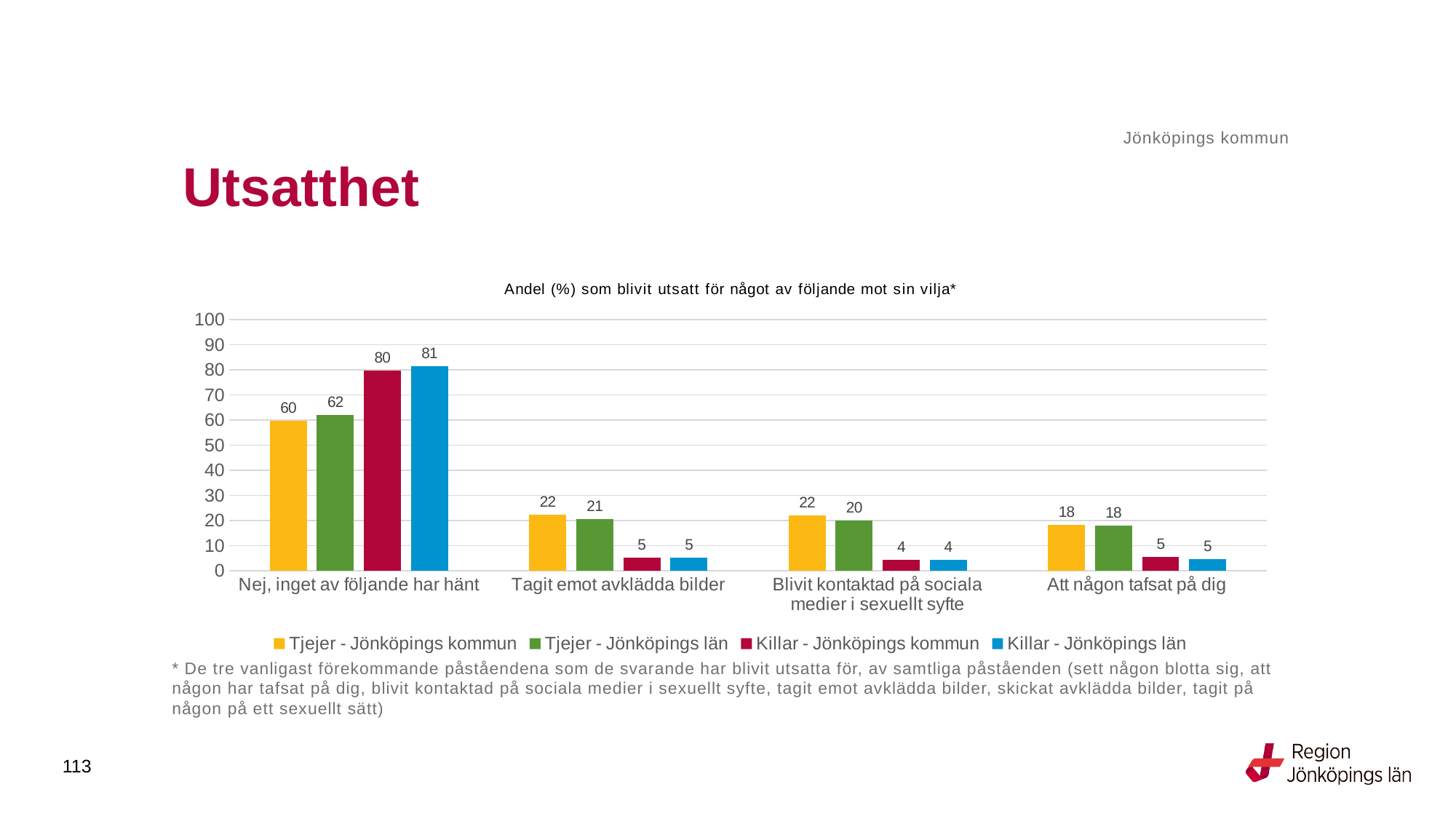
How many series does the legend list? 4 Which category has the lowest value for Killar - Jönköpings kommun? Blivit kontaktad på sociala medier i sexuellt syfte What is the value for Tjejer - Jönköpings län in the category 'Blivit kontaktad på sociala medier i sexuellt syfte'? 20 What is the difference between Killar - Jönköpings kommun and Tjejer - Jönköpings kommun in the category 'Nej, inget av följande har hänt'? 20 What is the value for Killar - Jönköpings län in the category 'Tagit emot avklädda bilder'? 5 What is the value for Tjejer - Jönköpings kommun in the category 'Nej, inget av följande har hänt'? 60 Is the value for Tjejer - Jönköpings län in the category 'Nej, inget av följande har hänt' greater or less than 50? greater Which is larger in the category 'Tagit emot avklädda bilder': Tjejer - Jönköpings kommun or Killar - Jönköpings kommun? Tjejer - Jönköpings kommun Which series has the highest value in the category 'Nej, inget av följande har hänt'? Killar - Jönköpings län How many categories are shown on the x axis? 4 What kind of chart is shown on the slide? Bar chart What is the title of the chart? Andel (%) som blivit utsatt för något av följande mot sin vilja*